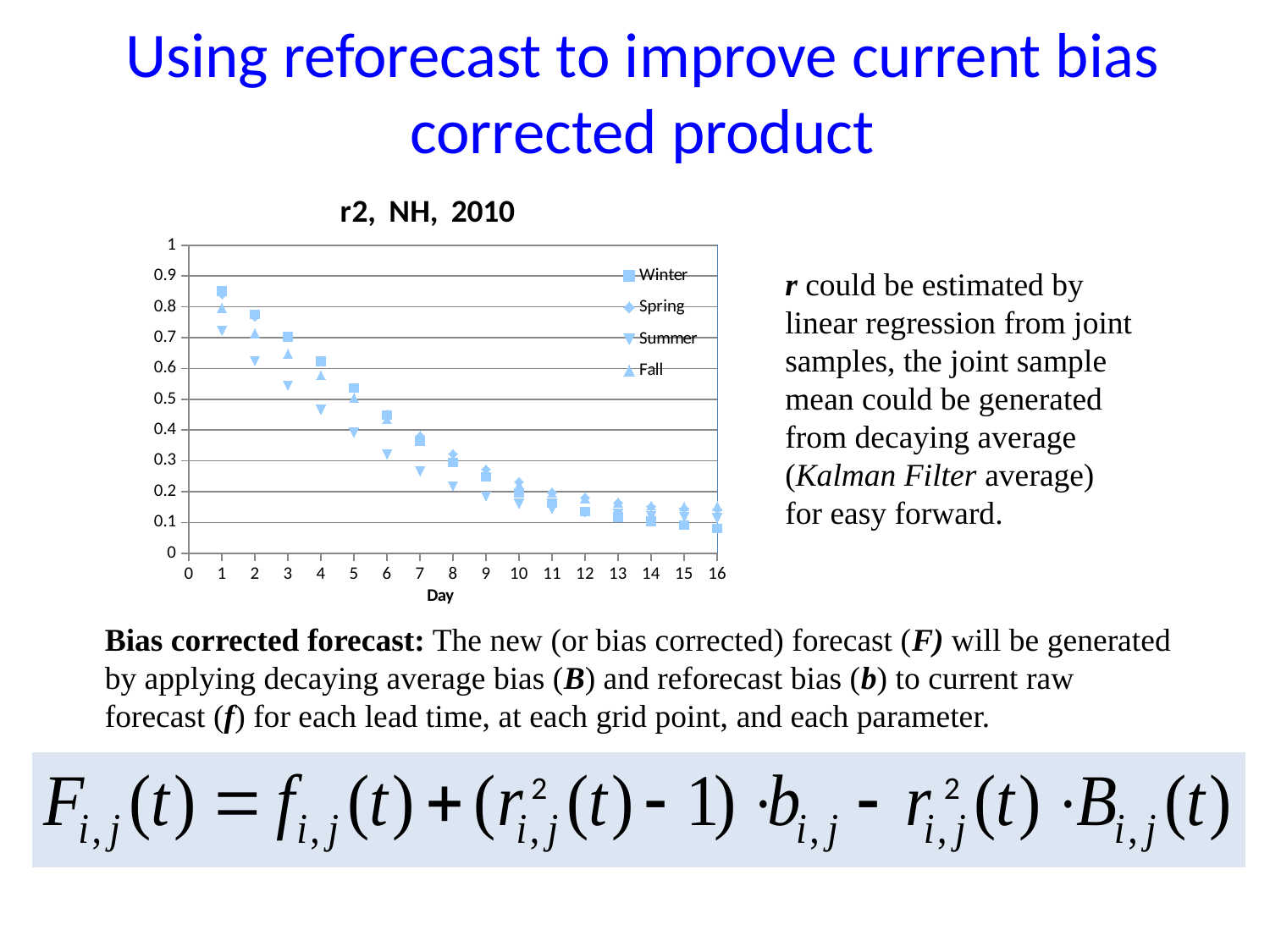
At Day 16, which series has the larger value, Fall or Winter? Fall How many series does the legend of the chart list? 4 What kind of chart is shown on the slide? scatter plot At Day 2, which series has the larger value, Winter or Summer? Winter Is the Winter value at Day 1 greater or less than 0.8? greater What is the label of the x axis of the chart? Day Do the values in the chart rise or fall as Day increases? fall Is the Summer value at Day 6 greater or less than 0.3? greater Is the Winter value at Day 16 greater or less than 0.1? less How many days are plotted for each series in the chart? 16 What is the title of the chart? r2, NH, 2010